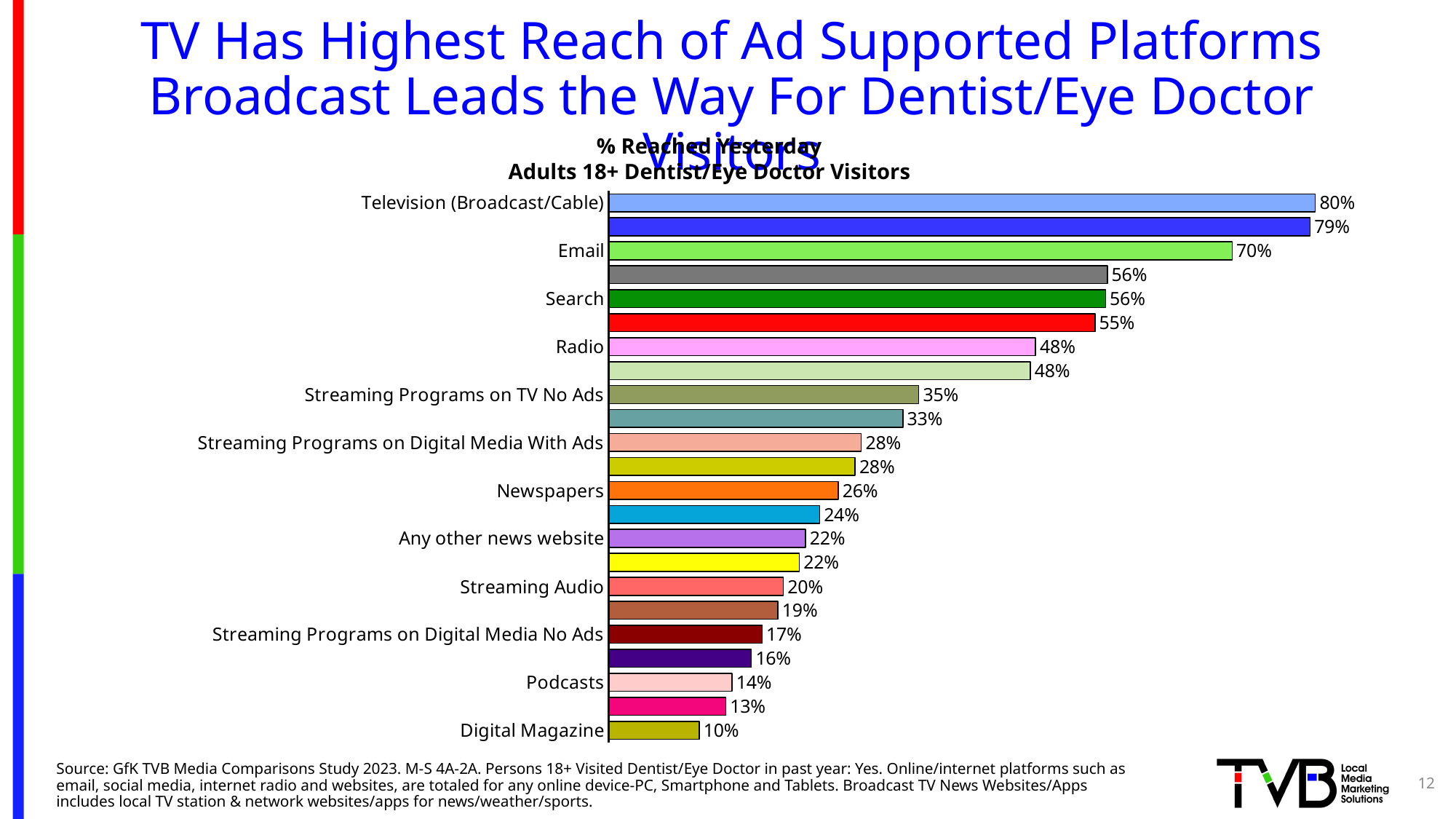
How many bars are plotted in the chart? 23 What kind of chart is shown on the slide? Bar chart What is the chart's title? % Reached Yesterday Adults 18+ Dentist/Eye Doctor Visitors Which category has the highest value? Television (Broadcast/Cable) Which category has the lowest value? Digital Magazine What is the value for Radio? 48% What is the value for Podcasts? 14% What is the value for Streaming Programs on TV No Ads? 35% Which is larger, the value for Newspapers or the value for Streaming Audio? Newspapers What is the value for Television (Broadcast/Cable)? 80% What is the difference between the values for Email and Search? 14 percentage points What is the value for Email? 70%